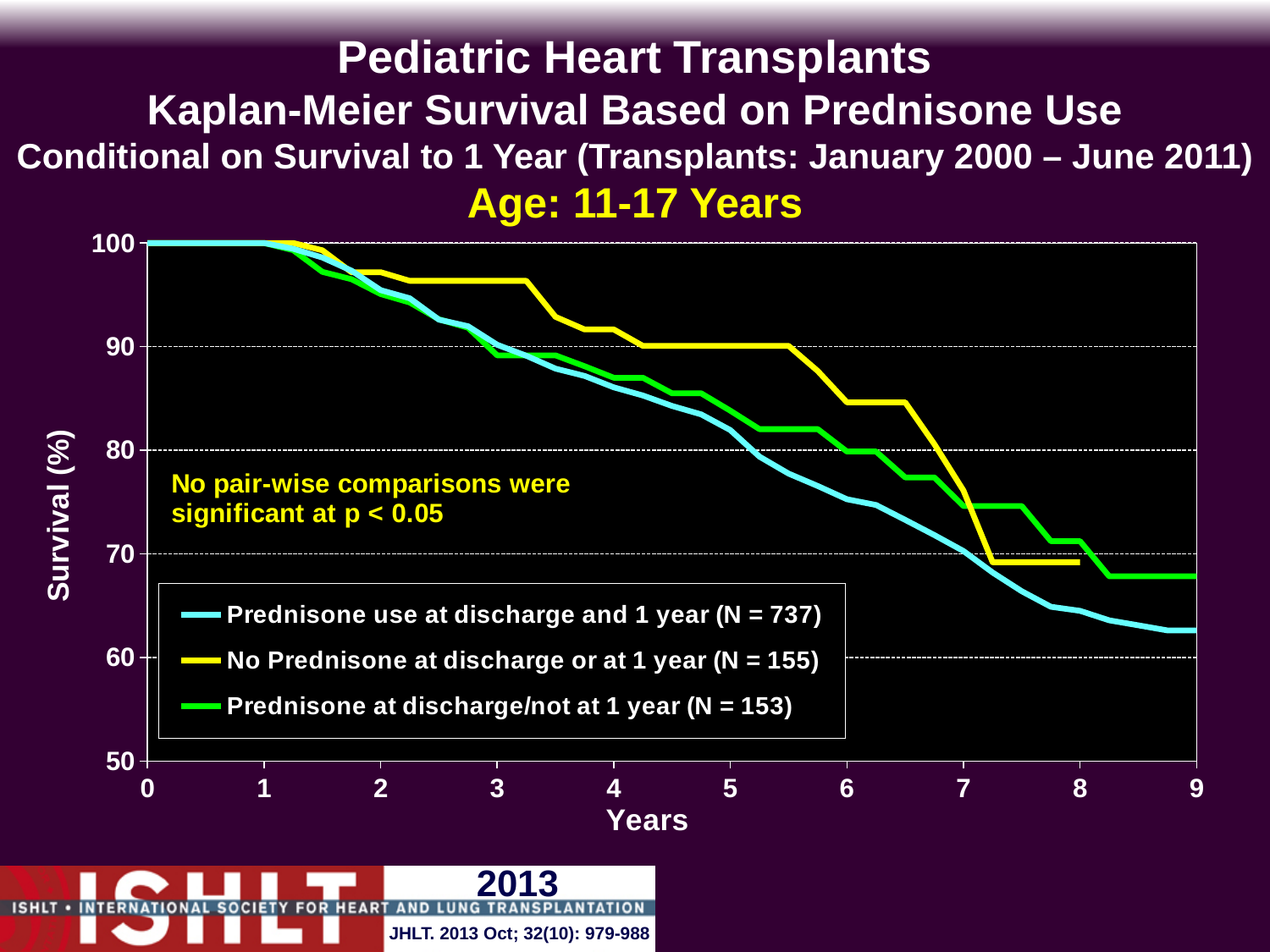
How many series does the legend list? 3 Is the survival for the 'Prednisone use at discharge and 1 year' group at year 9 greater or less than 70? less At year 9, which group has higher survival: 'Prednisone at discharge/not at 1 year' or 'Prednisone use at discharge and 1 year'? Prednisone at discharge/not at 1 year What is the N for the 'No Prednisone at discharge or at 1 year' group shown in the legend? 155 What is the survival value for all three groups at year 0? 100 What age group does the chart cover, according to the title? 11-17 Years What kind of chart is shown on the slide? Line chart Which group has the lowest survival at year 9? Prednisone use at discharge and 1 year (N = 737) Do the survival curves rise or fall as the years increase? Fall Is the survival for the 'Prednisone use at discharge and 1 year' group at year 6 greater or less than 80? less Is the survival for the 'No Prednisone at discharge or at 1 year' group at year 6 greater or less than 80? greater Which group has the highest survival at year 6? No Prednisone at discharge or at 1 year (N = 155)